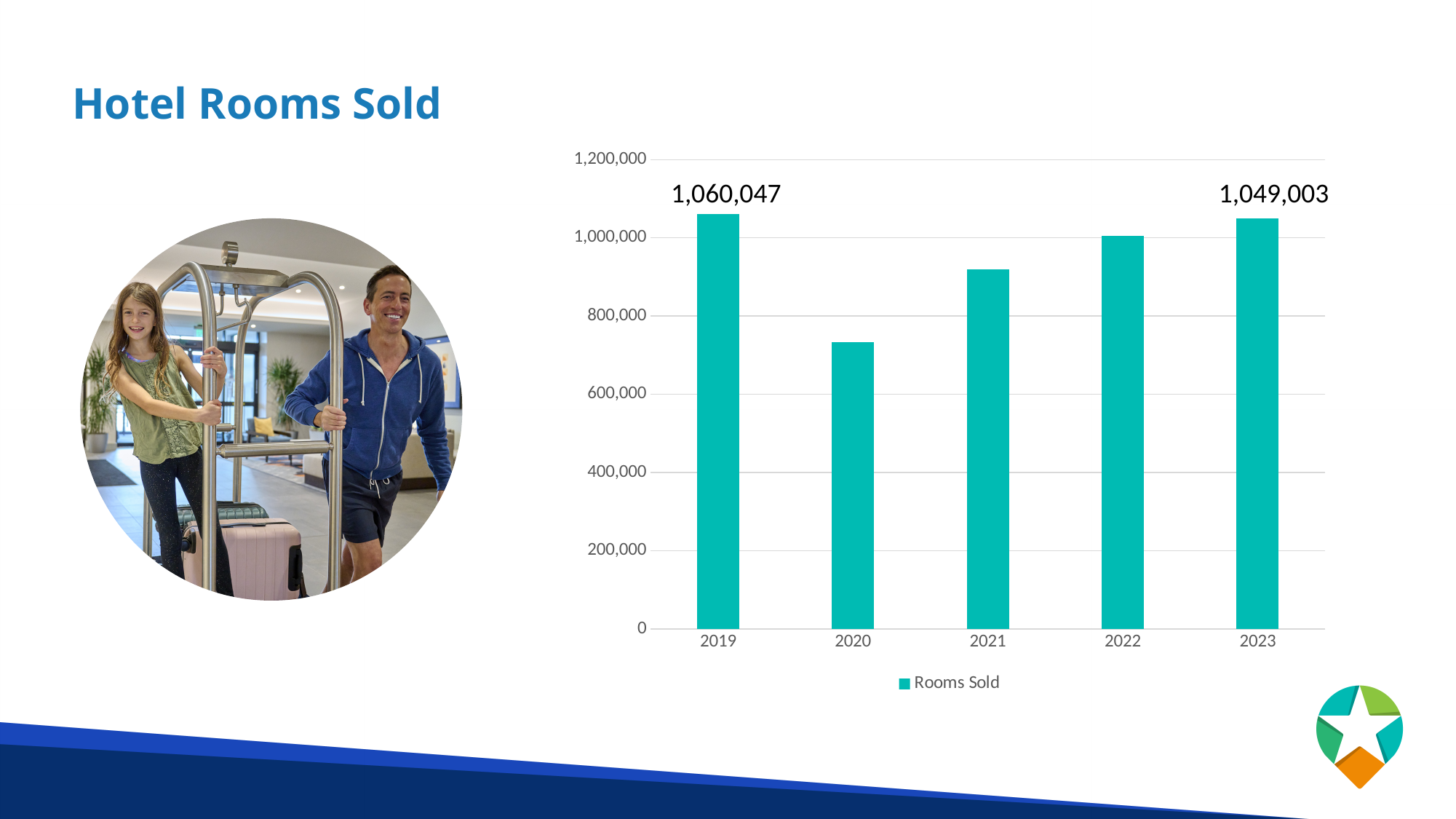
Which year had more rooms sold, 2019 or 2023? 2019 Which year has the highest number of rooms sold? 2019 How many hotel rooms were sold in 2019? 1,060,047 Is the value for 2020 greater or less than 800,000? less Is the value for 2021 greater or less than 1,000,000? less Which year has the lowest number of rooms sold? 2020 What kind of chart is shown on the slide? bar chart What is the difference between rooms sold in 2019 and rooms sold in 2023? 11,044 How many hotel rooms were sold in 2023? 1,049,003 How many years are shown on the x axis of the chart? 5 How many series does the legend list? 1 Is the value for 2021 greater or less than 800,000? greater